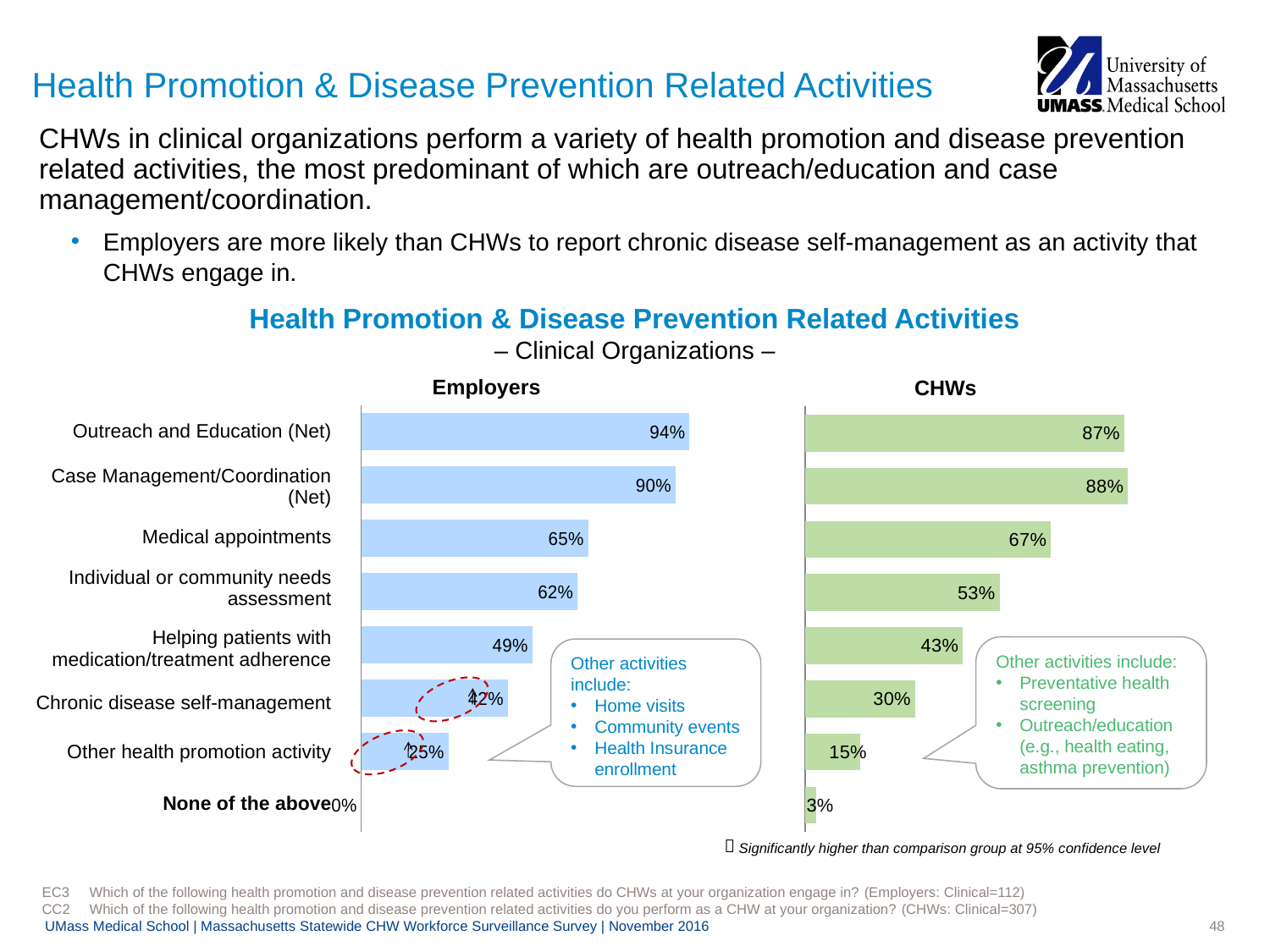
What is the difference between the Employers and CHWs percentages for Chronic disease self-management? 12 percentage points In the Employers chart, what percentage is shown for Helping patients with medication/treatment adherence? 49% In the CHWs chart, what percentage is shown for Individual or community needs assessment? 53% What type of chart is used to show the Employers data? Bar chart In the Employers chart, what is the difference between Outreach and Education (Net) and Case Management/Coordination (Net)? 4 percentage points What colour are the bars in the CHWs chart? Green In the Employers chart, which activity has the highest percentage? Outreach and Education (Net) For Medical appointments, which is larger: the Employers value or the CHWs value? CHWs In the CHWs chart, what percentage is shown for Case Management/Coordination (Net)? 88% In the Employers chart, what percentage is shown for Outreach and Education (Net)? 94% How many categories are shown in the CHWs chart? 8 In the CHWs chart, which category has the lowest percentage? None of the above